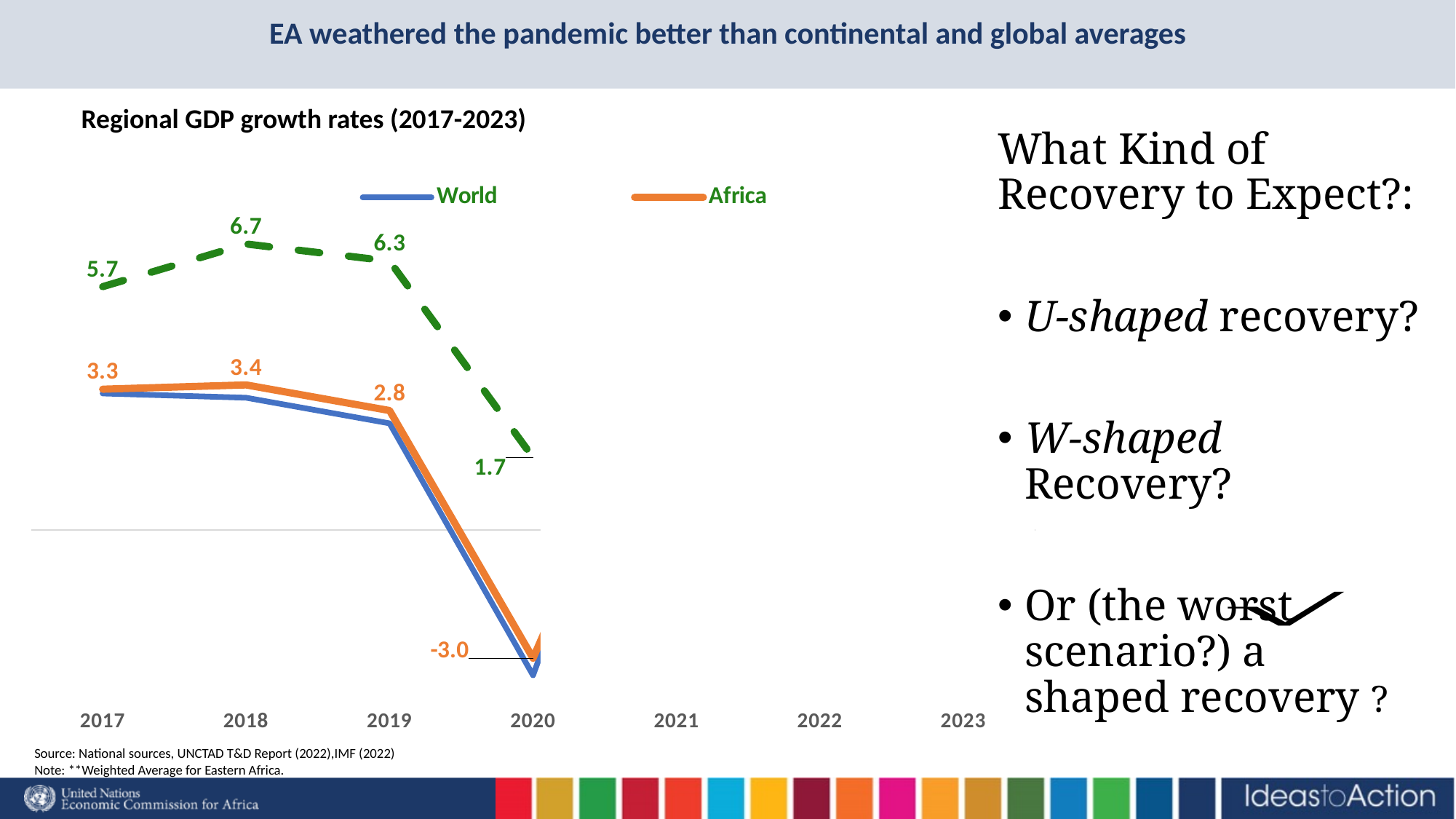
What is the value for Africa in 2019? 2.8 What kind of chart is shown on the slide? line chart In 2020, which series is higher, World or Africa? Africa How many series does the legend list? 2 Does the Africa series rise or fall from 2019 to 2020? fall In which year is the Africa series at its highest? 2018 What is the value for Africa in 2018? 3.4 What is the value for Africa in 2020? -3.0 In which year is the Africa series at its lowest? 2020 What is the difference between the Africa values for 2018 and 2020? 6.4 What is the value for Africa in 2017? 3.3 What is the difference between the Africa values for 2017 and 2019? 0.5